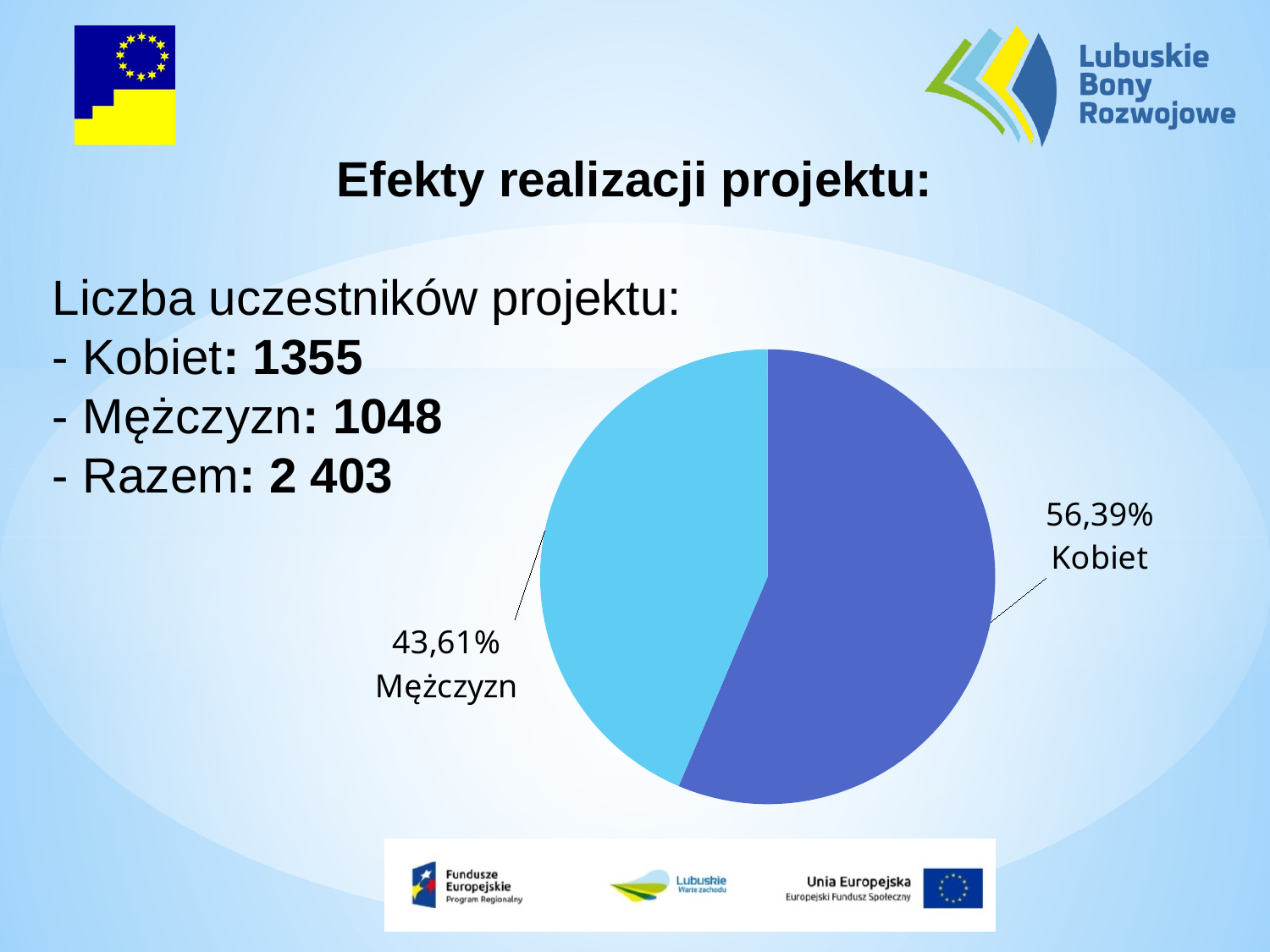
What share of the pie is labelled Kobiet? 56,39% Is the share for Kobiet greater or less than 50%? greater What kind of chart is shown on the slide? pie chart What colour is the Kobiet slice of the pie? dark blue What colour is the Mężczyzn slice of the pie? light blue Is the share for Mężczyzn greater or less than 50%? less How many slices does the pie chart have? 2 Which slice of the pie is the smallest? Mężczyzn What share of the pie is labelled Mężczyzn? 43,61% Which slice of the pie is the largest? Kobiet What is the difference in percentage points between the Kobiet and Mężczyzn slices? 12,78 Which slice is larger, Kobiet or Mężczyzn? Kobiet